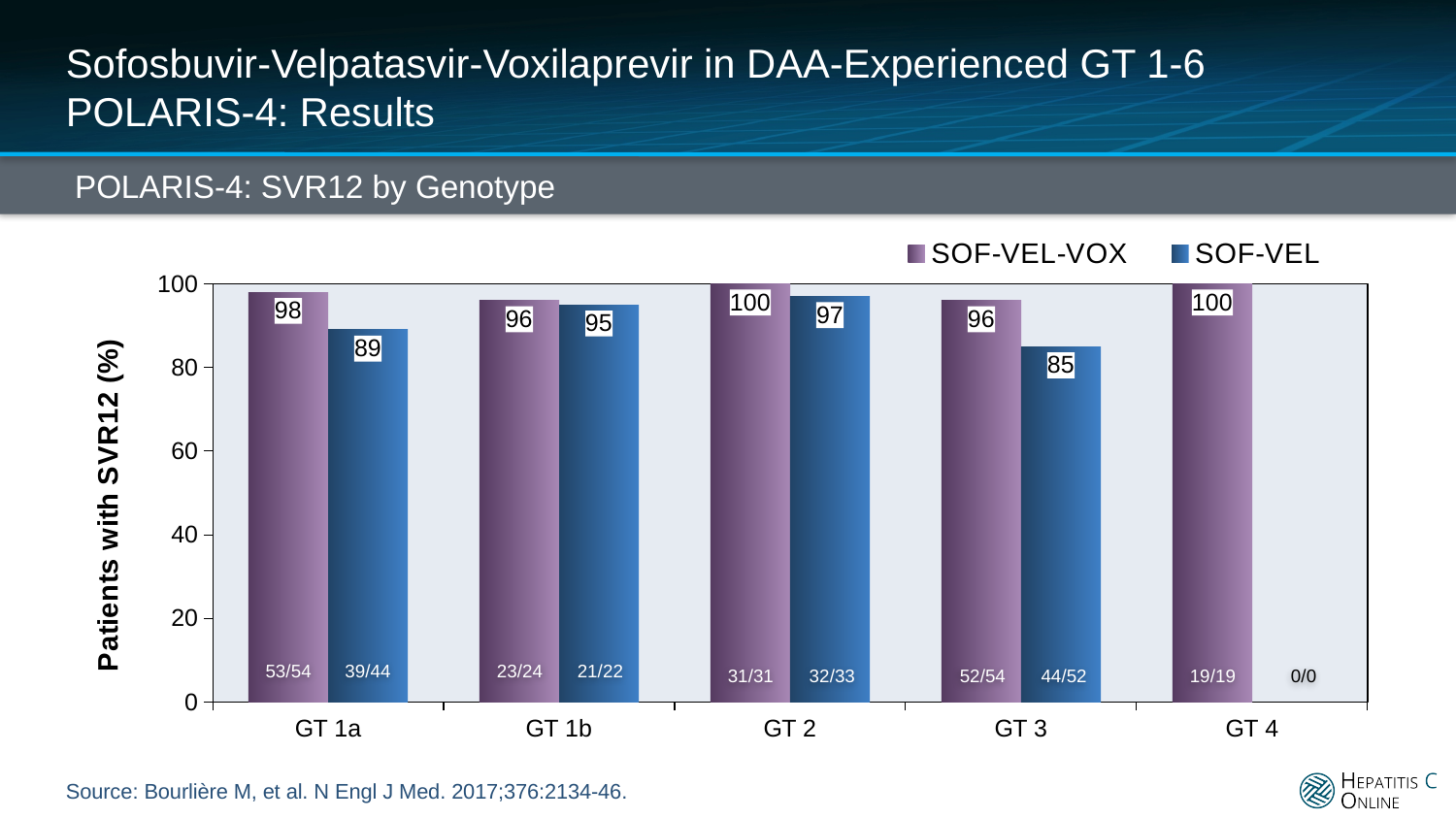
How many genotype categories are shown on the x axis? 5 What is the difference between the SOF-VEL-VOX and SOF-VEL SVR12 rates in GT 3? 11 What is the SVR12 rate for SOF-VEL in GT 3? 85 Which genotype has the lowest SVR12 rate for SOF-VEL? GT 3 What is the SVR12 rate for SOF-VEL-VOX in GT 1a? 98 What is the difference between the SOF-VEL-VOX and SOF-VEL SVR12 rates in GT 1a? 9 In GT 2, which regimen has the higher SVR12 rate, SOF-VEL-VOX or SOF-VEL? SOF-VEL-VOX What is the SVR12 rate for SOF-VEL in GT 1b? 95 What is the patient fraction shown for SOF-VEL in GT 4? 0/0 What is the label of the y axis? Patients with SVR12 (%) What kind of chart is shown on the slide? Bar chart How many series does the legend list? 2